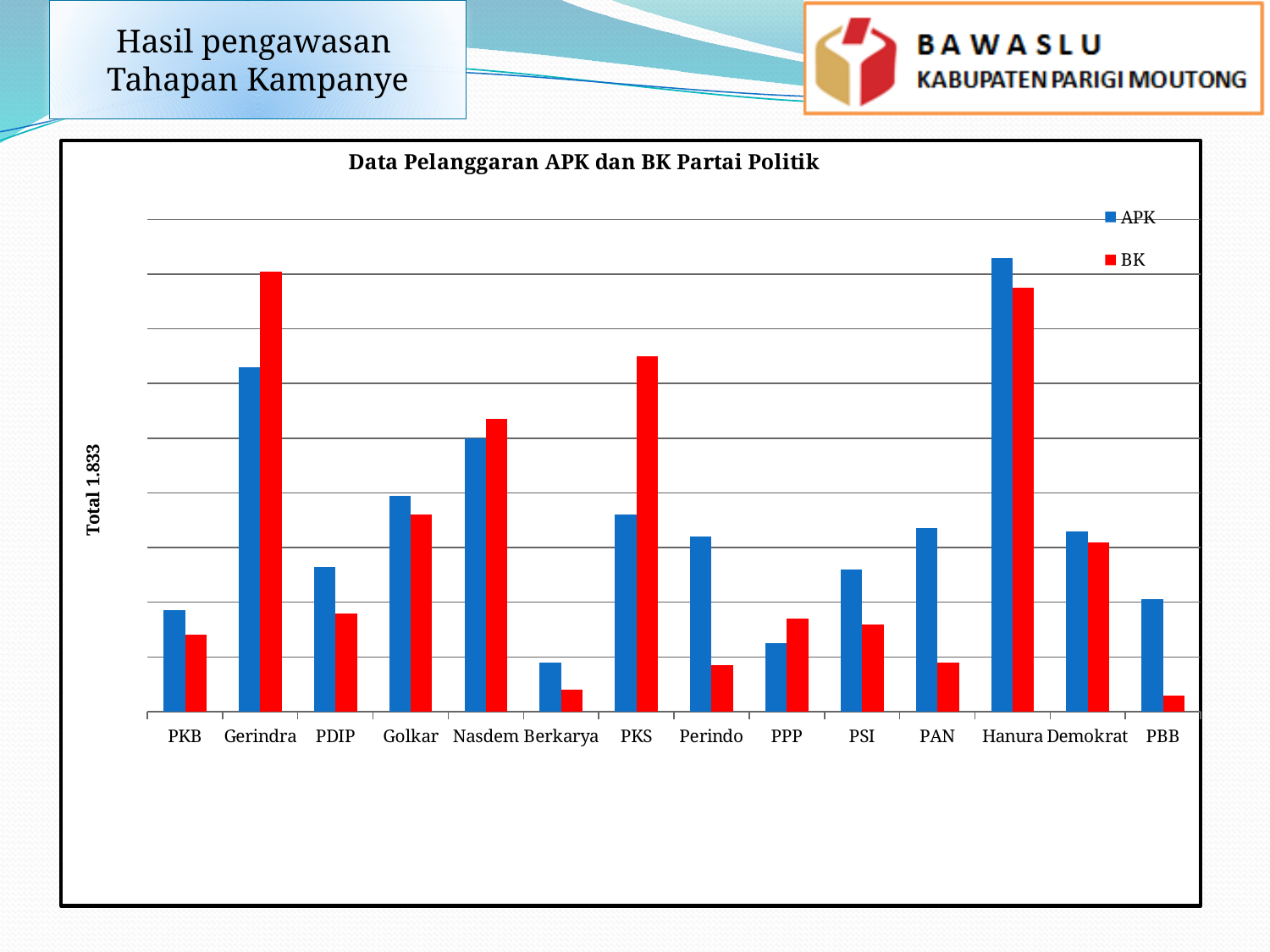
Which party has the lowest BK value? PBB For Gerindra, which is larger, APK or BK? BK Which party has the lowest APK value? Berkarya Which party has the highest BK value? Gerindra What text is written on the vertical axis of the chart? Total 1.833 For Hanura, which is larger, APK or BK? APK Which party has the highest APK value? Hanura What kind of chart is shown on the slide? Bar chart What is the title of the chart? Data Pelanggaran APK dan BK Partai Politik How many series does the legend list? 2 How many political parties are shown on the x axis? 14 For PKS, which is larger, APK or BK? BK